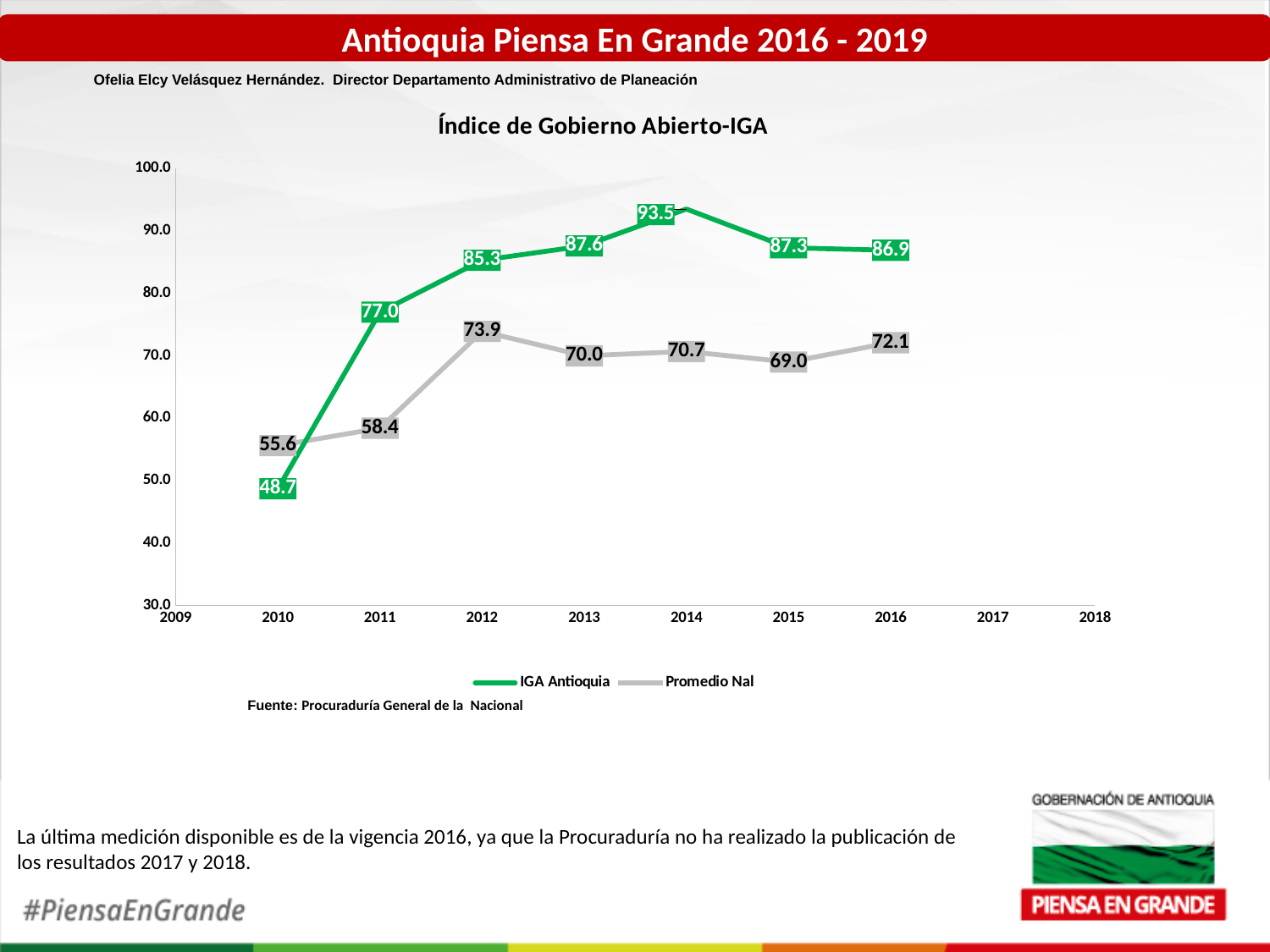
What kind of chart is shown on the slide? Line chart Which series has the larger value in 2010, IGA Antioquia or Promedio Nal? Promedio Nal Does the IGA Antioquia series rise or fall from 2010 to 2014? Rise What is the IGA Antioquia value for 2014? 93.5 What is the IGA Antioquia value for 2010? 48.7 What is the Promedio Nal value for 2012? 73.9 In which year is the Promedio Nal value lowest? 2010 In which year is the IGA Antioquia value highest? 2014 How many series does the legend list? 2 What is the title of the chart? Índice de Gobierno Abierto-IGA What is the difference between IGA Antioquia and Promedio Nal in 2016? 14.8 How many data points are plotted for the IGA Antioquia series? 7